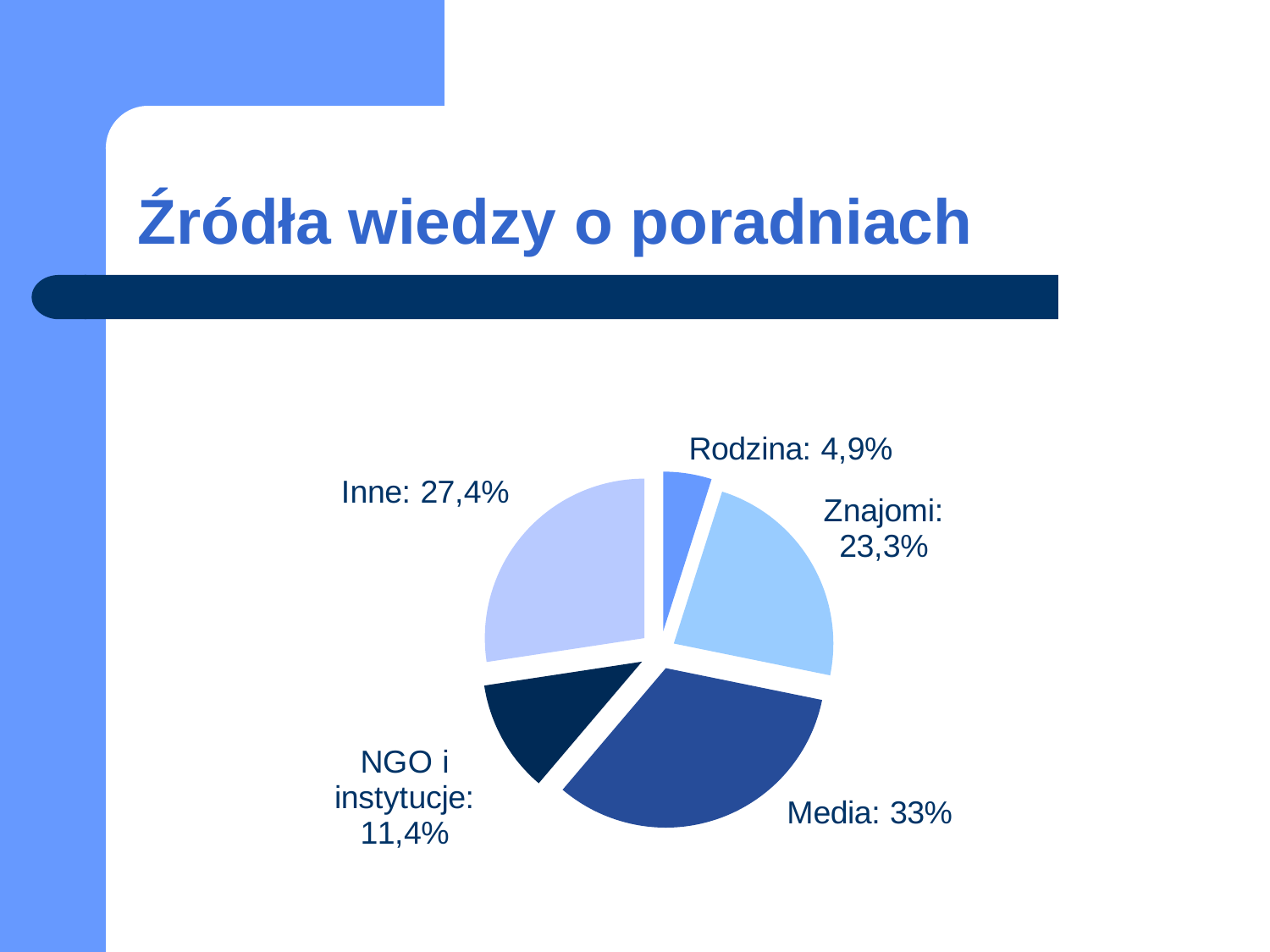
What is the difference between Znajomi and NGO i instytucje? 11,9% Which category has the largest share? Media What is the value for NGO i instytucje? 11,4% What is the title of the slide containing the chart? Źródła wiedzy o poradniach What is the value for Media? 33% What is the value for Znajomi? 23,3% What is the difference between Media and Inne? 5,6% How many slices does the pie chart have? 5 Which is larger, Inne or Znajomi? Inne What is the value for Rodzina? 4,9% Which category has the smallest share? Rodzina What kind of chart is shown on the slide? pie chart